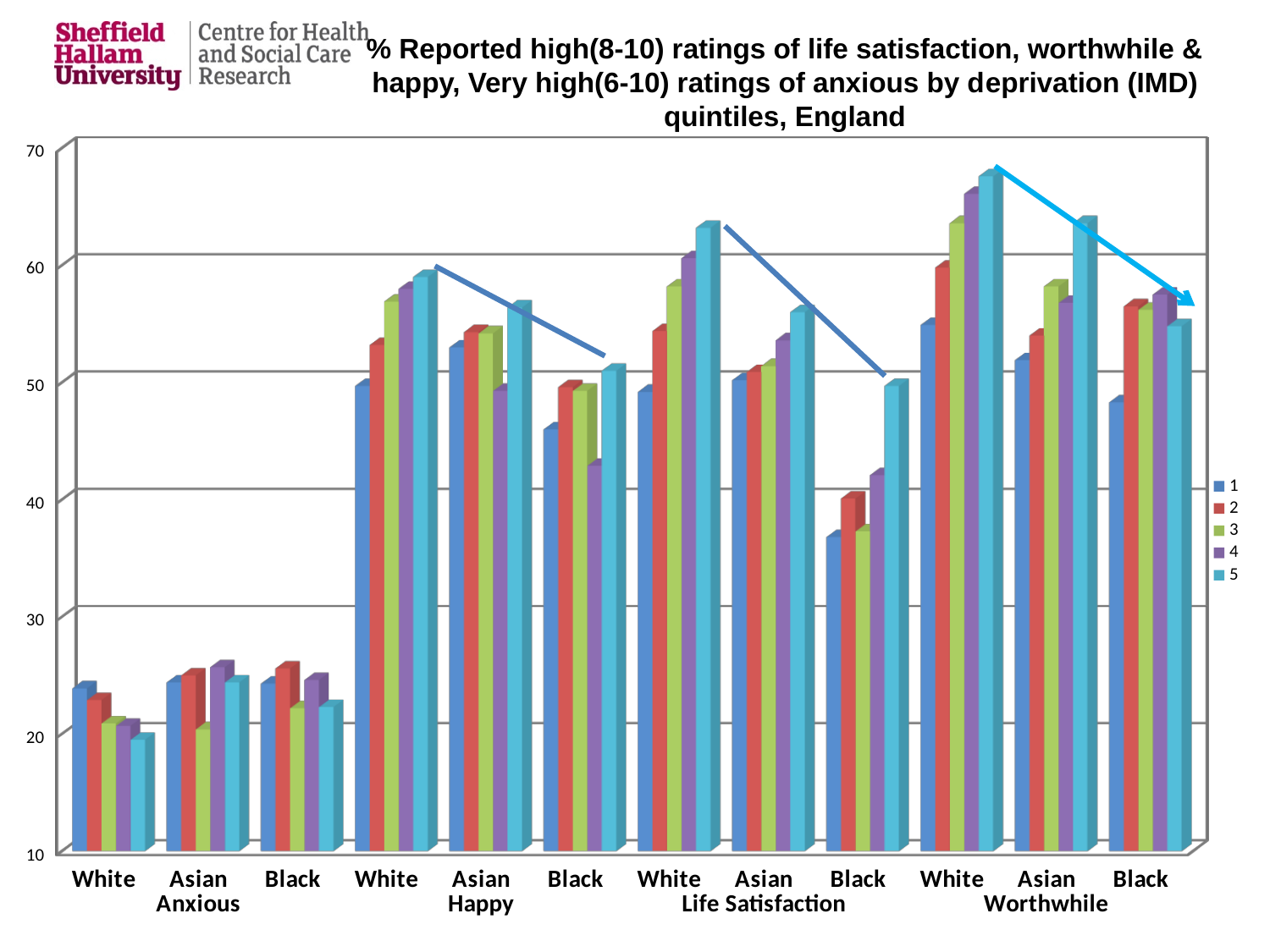
Is the value for series 1 for Black under Worthwhile greater or less than 50? less Within the Life Satisfaction group, which ethnic group has the lowest values? Black Which category and series has the tallest bar in the chart? White under Worthwhile, series 5 How many categories are shown along the x axis? 12 Is the value for series 1 for Black under Life Satisfaction greater or less than 40? less For White under Worthwhile, do the values rise or fall from series 1 to series 5? rise What are the entries listed in the legend? 1, 2, 3, 4, 5 How many series does the legend list? 5 Is the value for series 5 for White under Worthwhile greater or less than 60? greater Which is larger: series 1 for White under Life Satisfaction or series 1 for Black under Life Satisfaction? White under Life Satisfaction What kind of chart is shown on the slide? Bar chart